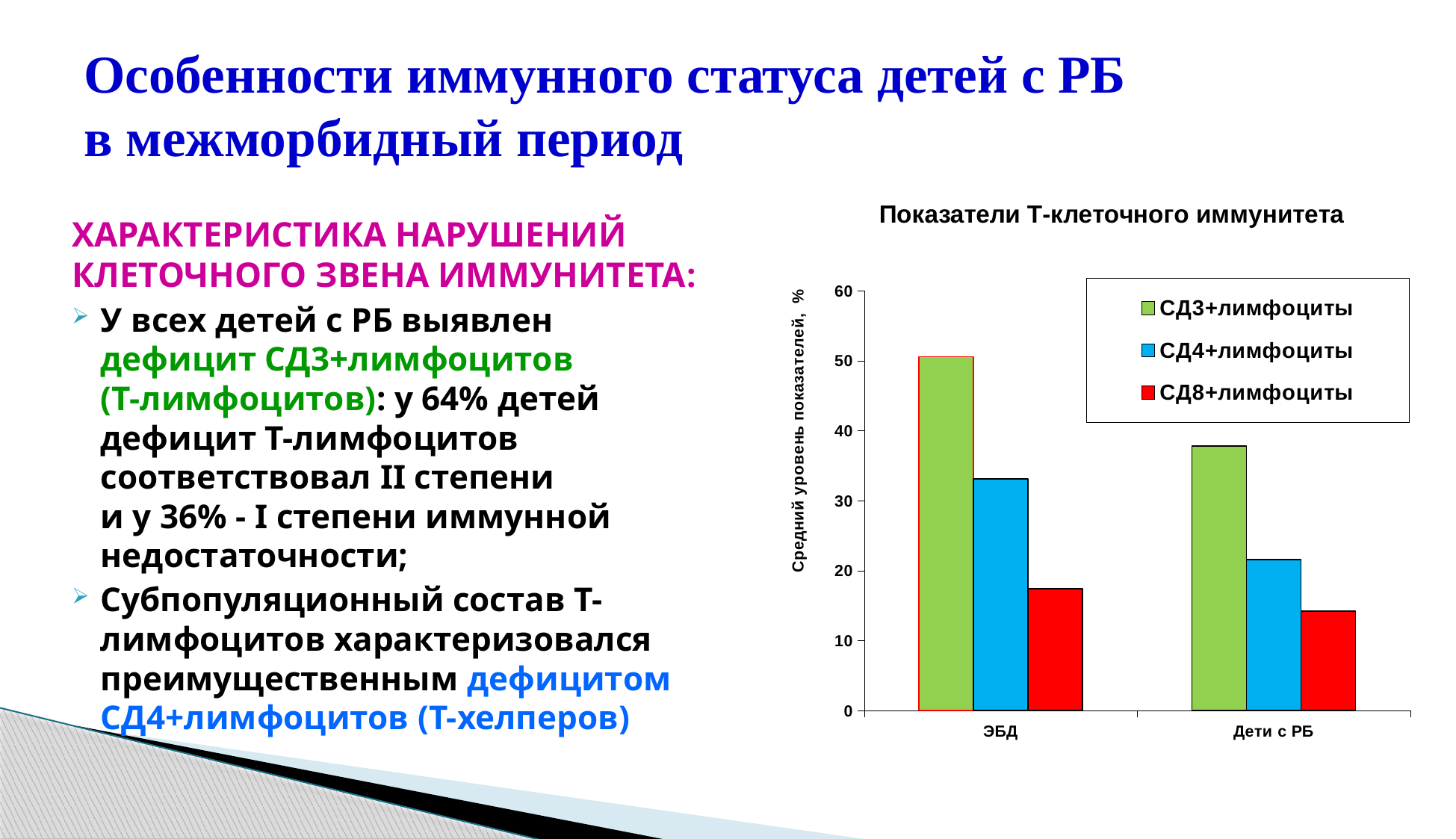
Is the value for СД3+лимфоциты in the ЭБД group greater or less than 40? greater How many categories are shown on the x axis of the chart? 2 What kind of chart is shown on the slide? bar chart Which series has the lowest bar in the Дети с РБ group? СД8+лимфоциты Is the value for СД4+лимфоциты in the Дети с РБ group greater or less than 30? less Which group has the larger value for СД4+лимфоциты, ЭБД or Дети с РБ? ЭБД How many series does the chart legend list? 3 What is the title of the chart? Показатели Т-клеточного иммунитета Is the value for СД3+лимфоциты in the Дети с РБ group greater or less than 30? greater Which series has the highest bar in the ЭБД group? СД3+лимфоциты Which series is shown in red in the chart? СД8+лимфоциты